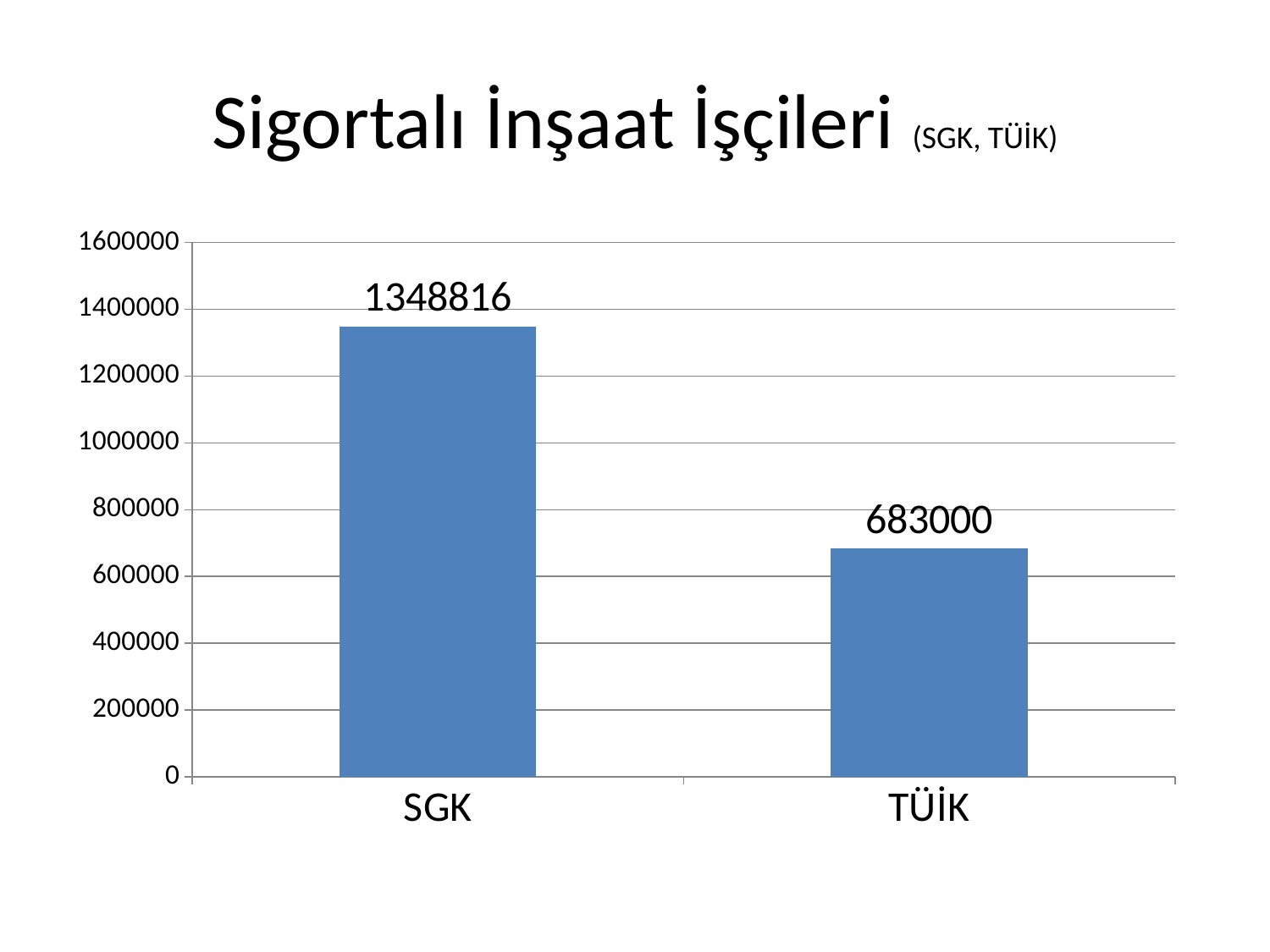
What kind of chart is shown on the slide? bar chart What is the value for SGK? 1348816 Which category has the highest value? SGK Which category has the lowest value? TÜİK Is the value for SGK greater or less than 1200000? greater What is the highest value shown on the y axis? 1600000 What is the difference between the SGK and TÜİK values? 665816 Which is larger, the value for SGK or the value for TÜİK? SGK Is the value for TÜİK greater or less than 800000? less What is the value for TÜİK? 683000 How many categories are shown on the x axis? 2 What is the title of the slide? Sigortalı İnşaat İşçileri (SGK, TÜİK)